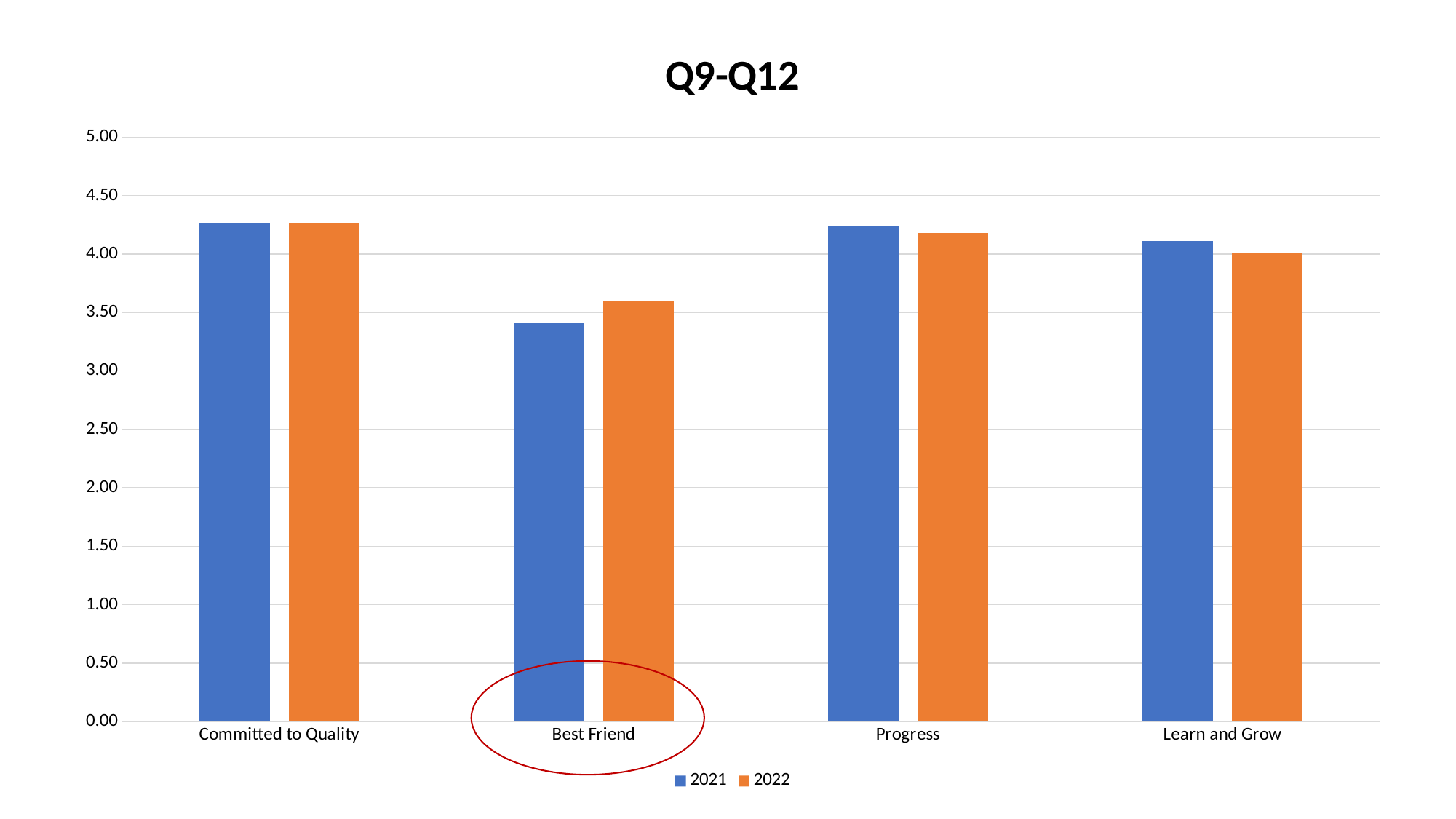
What kind of chart is shown on the slide? Bar chart How many categories are shown on the x axis? 4 For Best Friend, which is larger: the 2021 value or the 2022 value? 2022 Is the 2022 value for Best Friend greater or less than 3.50? greater Is the 2021 value for Best Friend greater or less than 3.50? less For Learn and Grow, which is larger: the 2021 value or the 2022 value? 2021 How many series does the legend list? 2 Which category on the x axis is circled in red? Best Friend Which category has the lowest value for 2022? Best Friend What is the title of the chart? Q9-Q12 Is the 2021 value for Committed to Quality greater or less than 4.50? less Which category has the lowest value for 2021? Best Friend